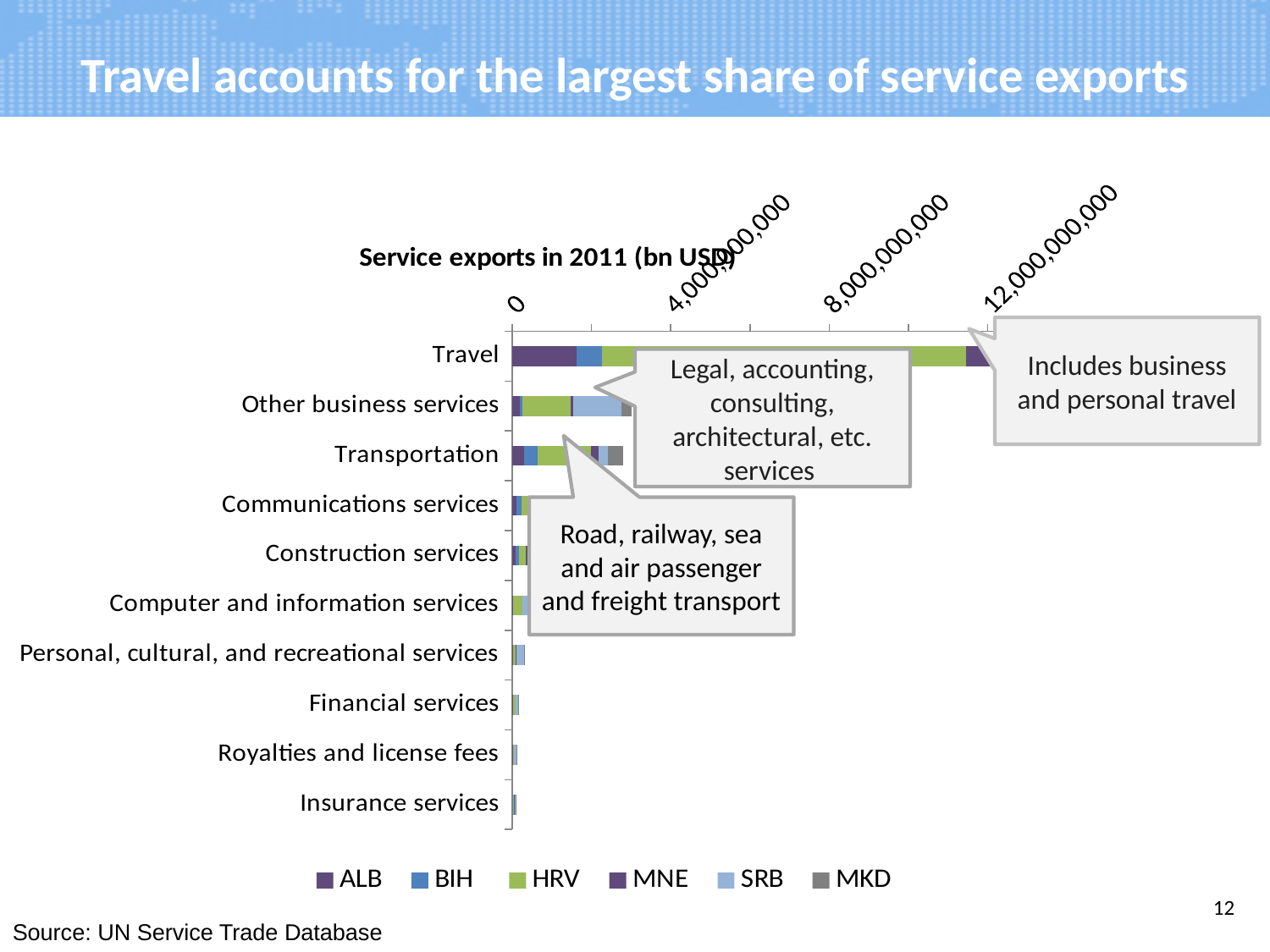
Is the total value for Other business services greater or less than 4,000,000,000? less What is the title of the chart? Service exports in 2011 (bn USD) Which service category has the smallest total export value? Insurance services How many service categories are plotted on the chart? 10 Is the total value for Travel greater or less than 8,000,000,000? greater Which country code in the legend is shown in green? HRV Which has a larger total export value, Financial services or Other business services? Other business services Which service category has the largest total export value? Travel How many series does the legend list? 6 Which has a larger total export value, Travel or Other business services? Travel What kind of chart is shown on the slide? Stacked bar chart Is the total value for Transportation greater or less than 4,000,000,000? less